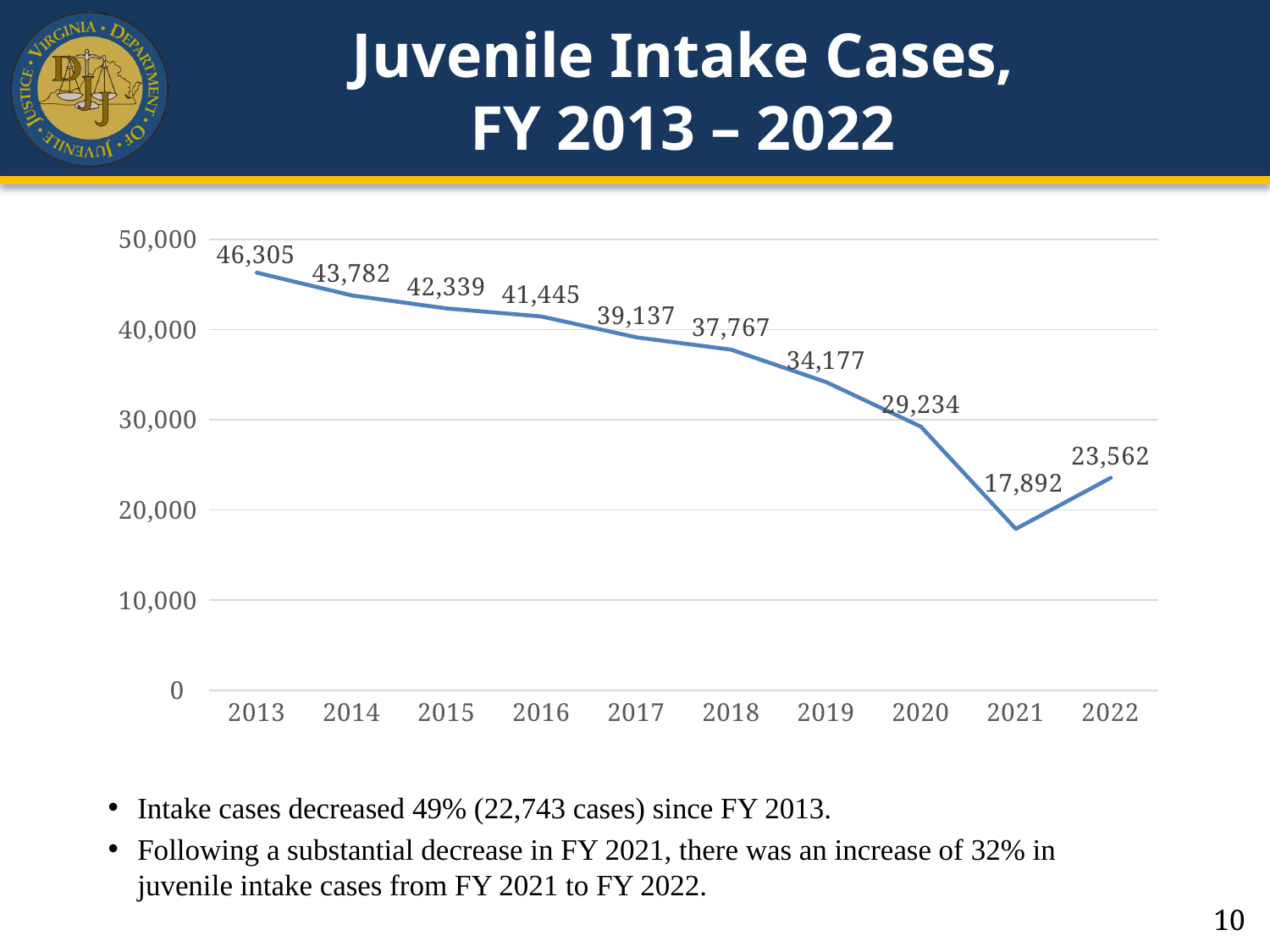
What was the number of juvenile intake cases in FY 2021? 17,892 Which year had more juvenile intake cases, 2019 or 2022? 2019 What is the difference in juvenile intake cases between FY 2020 and FY 2021? 11,342 What was the number of juvenile intake cases in FY 2013? 46,305 How many years are plotted on the chart? 10 Which year had the lowest number of juvenile intake cases? 2021 What type of chart is shown on the slide? Line chart Which year had the highest number of juvenile intake cases? 2013 What was the number of juvenile intake cases in FY 2018? 37,767 What was the number of juvenile intake cases in FY 2022? 23,562 What is the overall trend in juvenile intake cases from 2013 to 2021? Decreasing What is the difference in juvenile intake cases between FY 2013 and FY 2022? 22,743